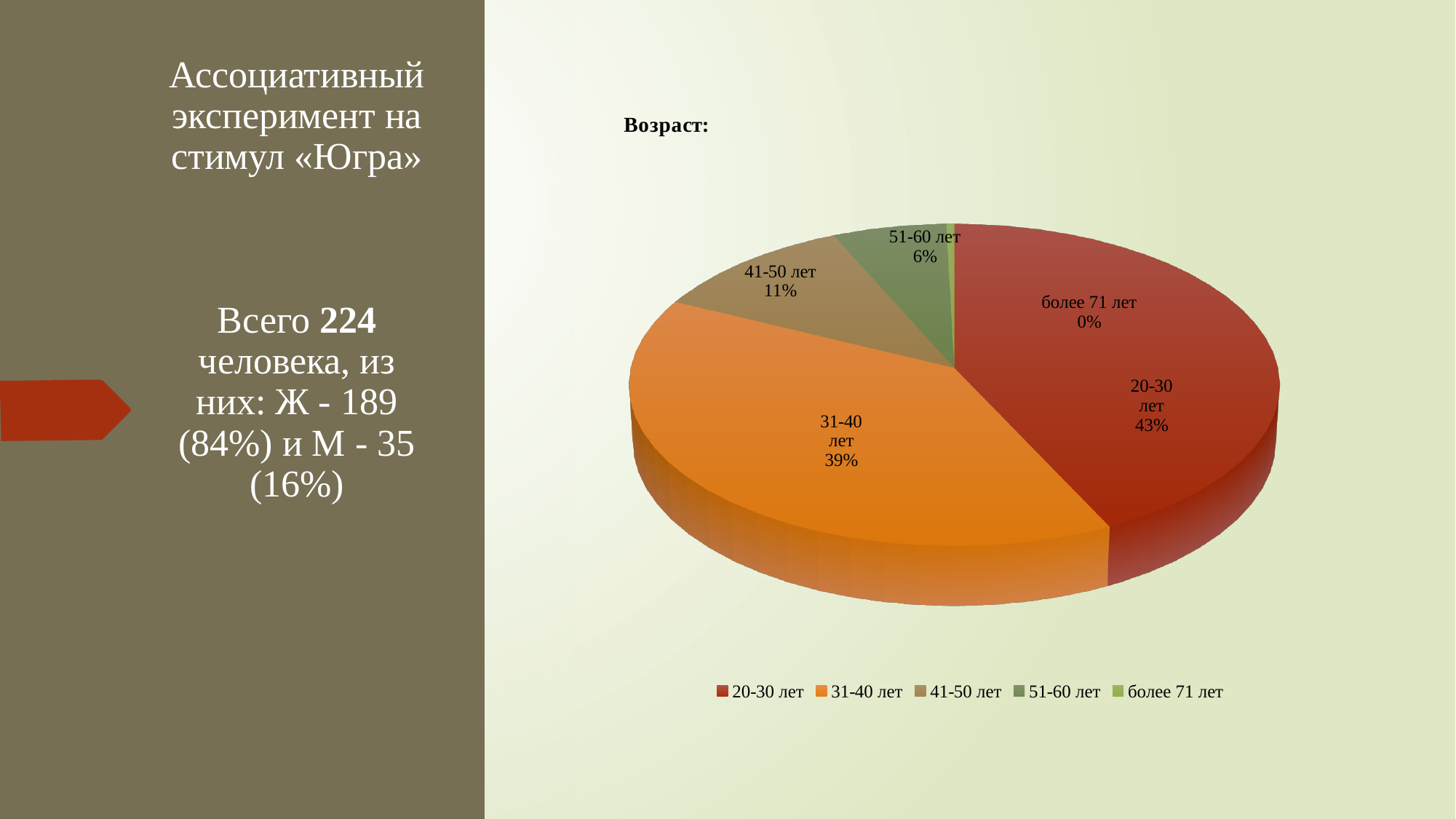
What is the value shown for 51-60 лет? 6% What kind of chart is shown on the slide? pie chart What is the value shown for более 71 лет? 0% Which age group has the smallest slice of the pie? более 71 лет What share of the pie does the 20-30 лет slice represent? 43% What is the value shown for 31-40 лет? 39% What is the title of the chart? Возраст: How many categories does the legend list? 5 What is the difference in percentage points between the 20-30 лет and 31-40 лет slices? 4% Which age group has the largest slice of the pie? 20-30 лет What is the value shown for 41-50 лет? 11% Which is larger, the 41-50 лет slice or the 51-60 лет slice? 41-50 лет